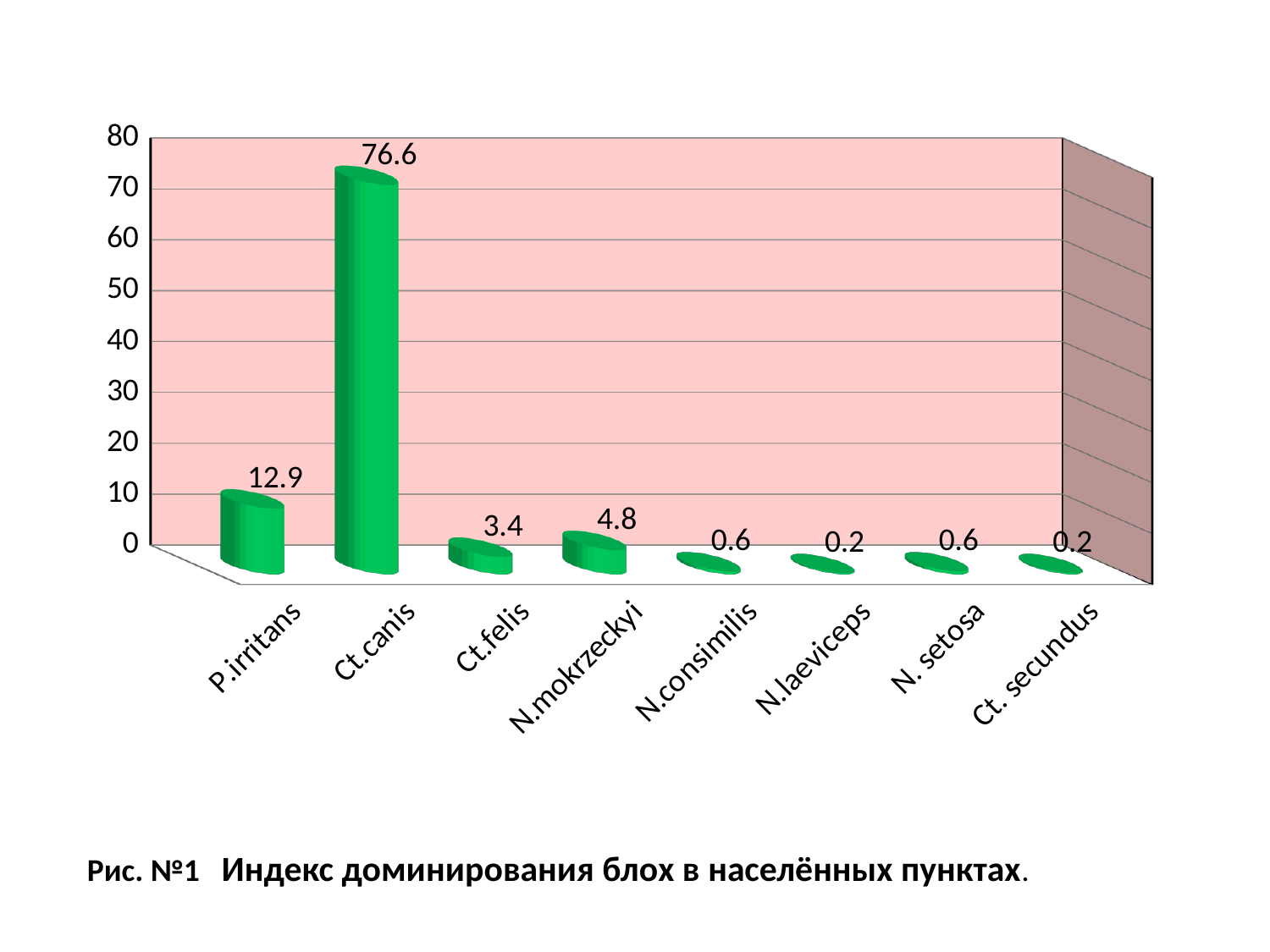
Which category has the highest value? Ct.canis What is the difference between the values for N.mokrzeckyi and Ct.felis? 1.4 What kind of chart is shown on the slide? bar chart Is the value for Ct.canis greater or less than 70? greater What is the difference between the values for Ct.canis and P.irritans? 63.7 What is the value for N.mokrzeckyi? 4.8 Which is larger, the value for P.irritans or the value for N.mokrzeckyi? P.irritans How many categories are shown on the x axis? 8 What is the value for P.irritans? 12.9 What is the value for Ct.felis? 3.4 What is the caption of the figure below the chart? Рис. №1 Индекс доминирования блох в населённых пунктах. What is the value for Ct.canis? 76.6